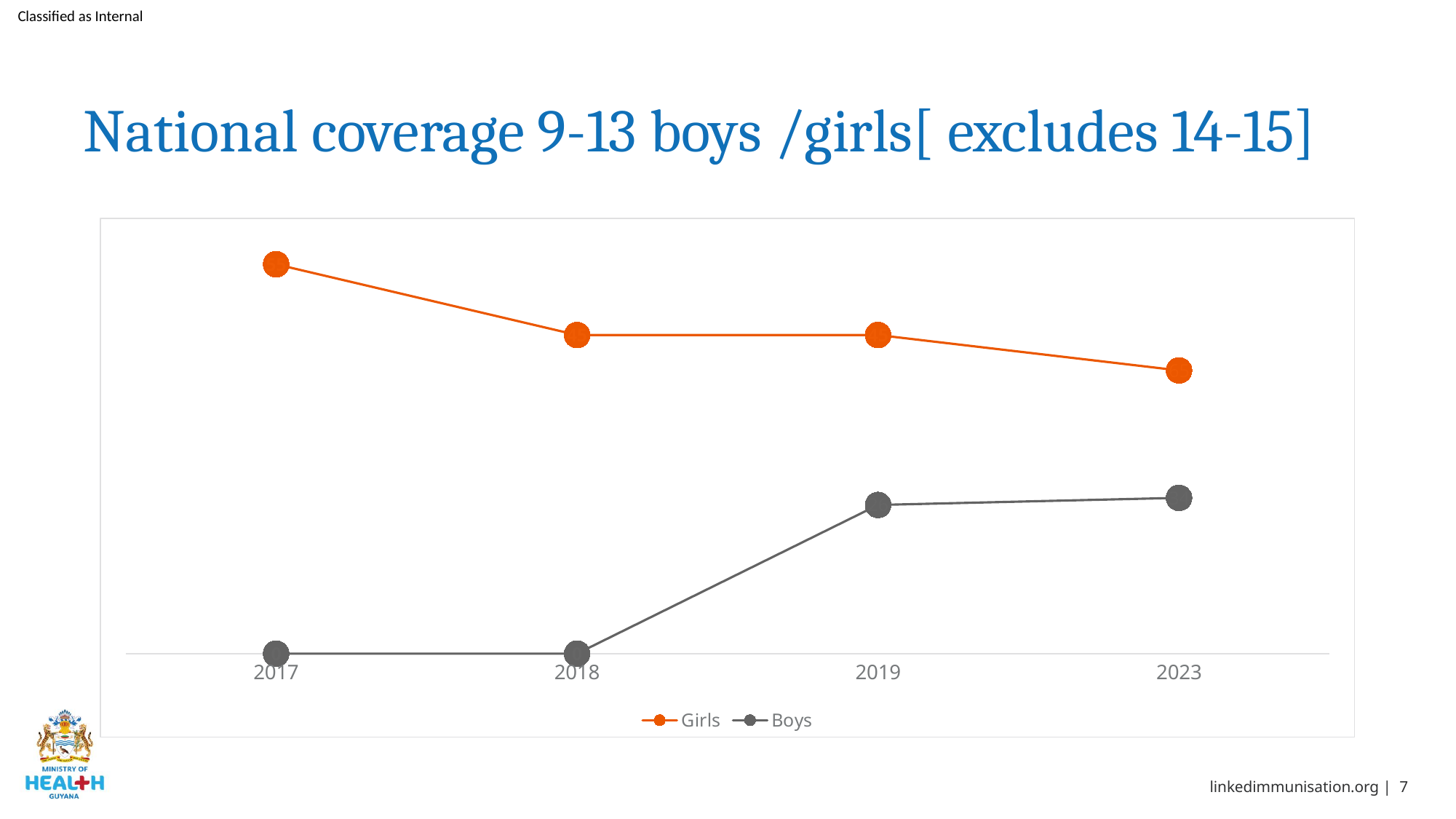
Which series is lower in 2023, Girls or Boys? Boys How many years are plotted along the x axis? 4 Does the Boys series rise or fall from 2018 to 2019? Rise In which year is the Girls series at its highest? 2017 What kind of chart is shown on the slide? Line chart Which series is higher in 2019, Girls or Boys? Girls Which series is drawn in orange? Girls How many series does the legend list? 2 Does the Girls series rise or fall from 2017 to 2023? Fall Which series is higher in 2017, Girls or Boys? Girls In which year is the Girls series at its lowest? 2023 What is the title of the slide containing the chart? National coverage 9-13 boys /girls[ excludes 14-15]